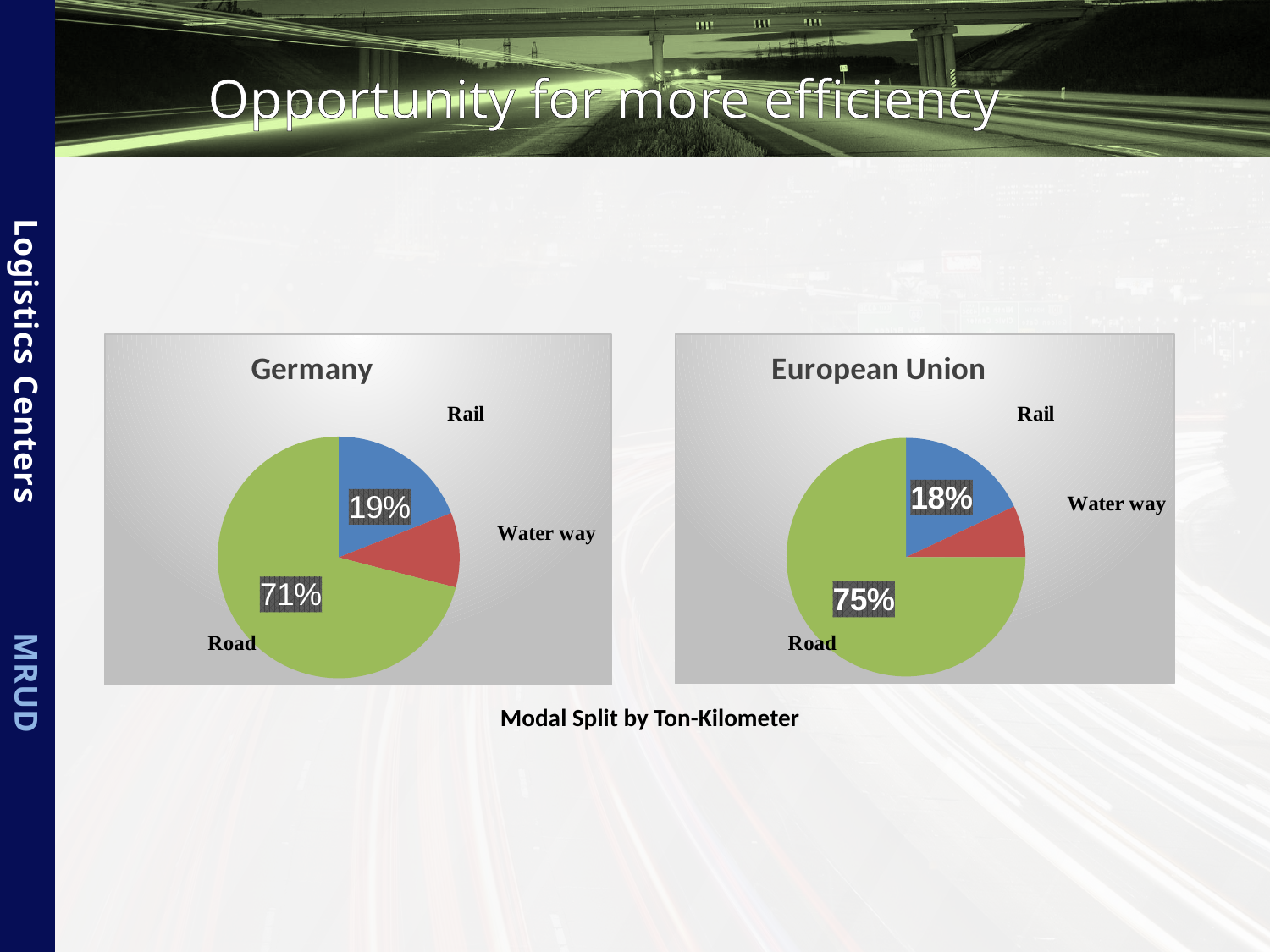
How many slices does the Germany chart have? 3 In the Germany chart, what percentage is shown for Rail? 19% In the European Union chart, which category has the smallest slice? Water way In the European Union chart, how many percentage points larger is Road than Rail? 57 In the European Union chart, what percentage is shown for Road? 75% In the European Union chart, what percentage is shown for Rail? 18% What is the caption printed below the two charts? Modal Split by Ton-Kilometer Is the Road share larger in the Germany chart or in the European Union chart? European Union What type of chart is the European Union chart? Pie chart In the Germany chart, how many percentage points larger is Road than Rail? 52 In the Germany chart, which category has the largest slice? Road In the Germany chart, what percentage is shown for Road? 71%